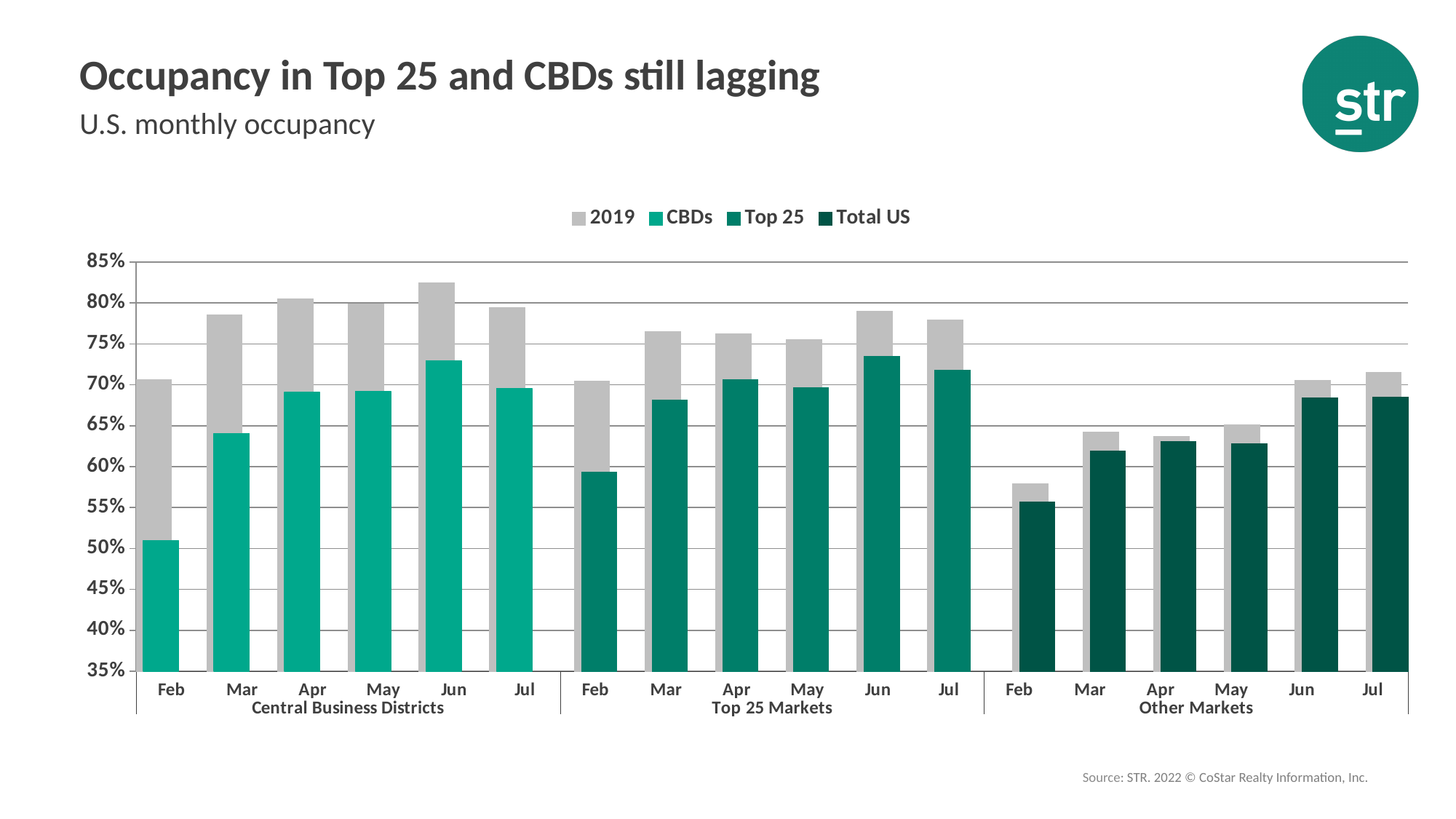
Is the Total US value for Feb in the Other Markets group greater or less than 60%? less Do the CBDs values rise or fall from Feb to Jun? rise Is the Top 25 value for Feb greater or less than 65%? less What type of chart is shown on the slide? Bar chart How many months are plotted within the Central Business Districts group? 6 In the Central Business Districts group, which month has the lowest CBDs bar? Feb How many market groups are shown along the x axis? 3 In the Central Business Districts group, which month has the highest CBDs bar? Jun How many series does the legend list? 4 Is the CBDs value for Feb greater or less than 55%? less Which is larger: the 2019 bar for Jun in Central Business Districts or the 2019 bar for Jun in Top 25 Markets? Jun in Central Business Districts